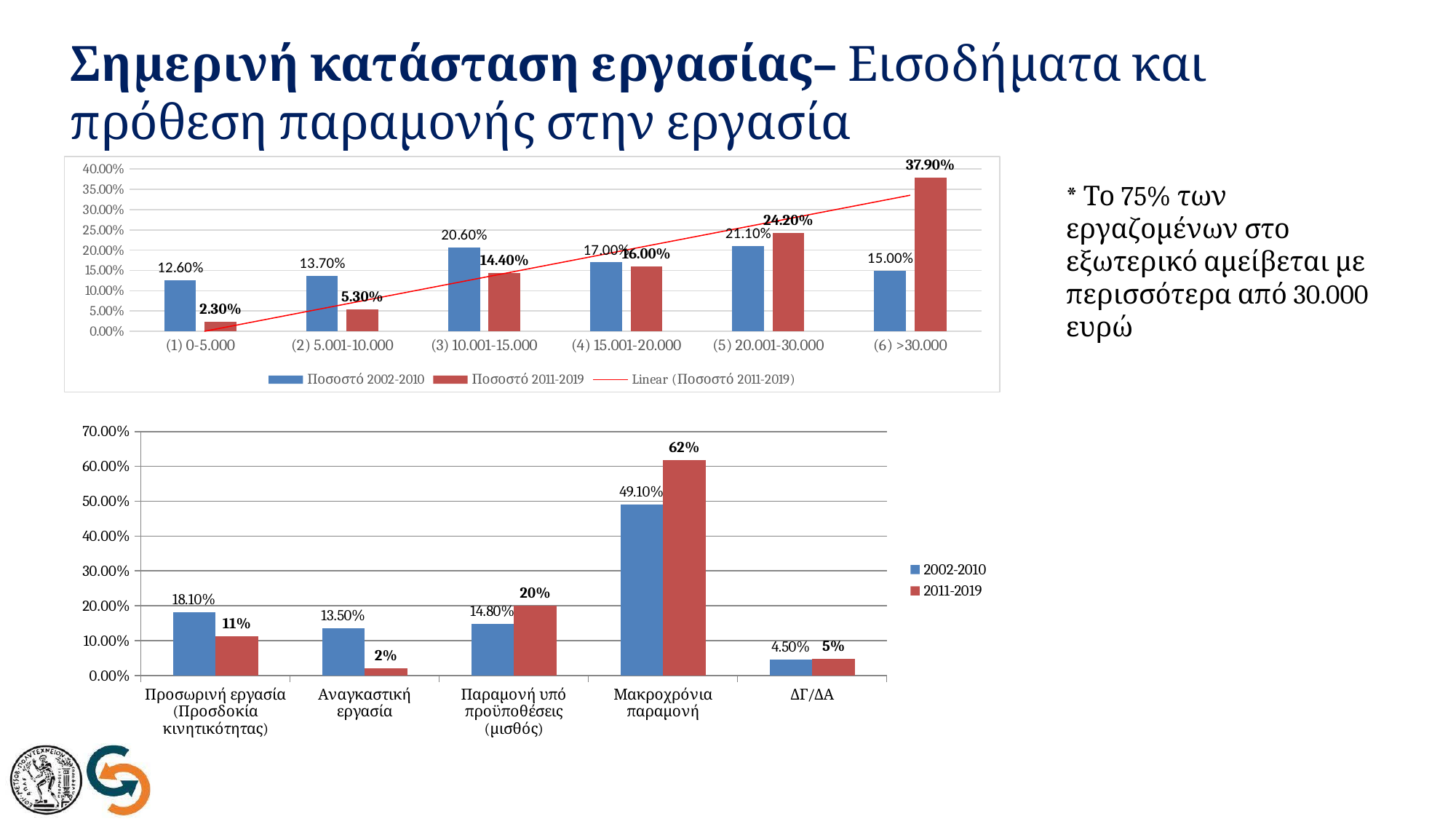
In the top chart, what is the value of Ποσοστό 2002-2010 for the category (3) 10.001-15.000? 20.60% How many categories are shown on the x axis of the bottom chart? 5 In the top chart, does the Ποσοστό 2011-2019 series rise or fall across the income categories from left to right? rise How many entries does the legend of the top chart list? 3 In the bottom chart, what is the value of 2011-2019 for Μακροχρόνια παραμονή? 62% In the bottom chart, which category has the highest value for 2002-2010? Μακροχρόνια παραμονή In the top chart, which category has the lowest value for Ποσοστό 2011-2019? (1) 0-5.000 In the bottom chart, which is larger for Παραμονή υπό προϋποθέσεις (μισθός): 2002-2010 or 2011-2019? 2011-2019 In the bottom chart, what is the value of 2002-2010 for Αναγκαστική εργασία? 13.50% In the top chart, what is the value of Ποσοστό 2011-2019 for the category (6) >30.000? 37.90% What type of chart is the bottom chart? bar chart In the top chart, what is the difference between Ποσοστό 2002-2010 and Ποσοστό 2011-2019 for the category (1) 0-5.000? 10.30%